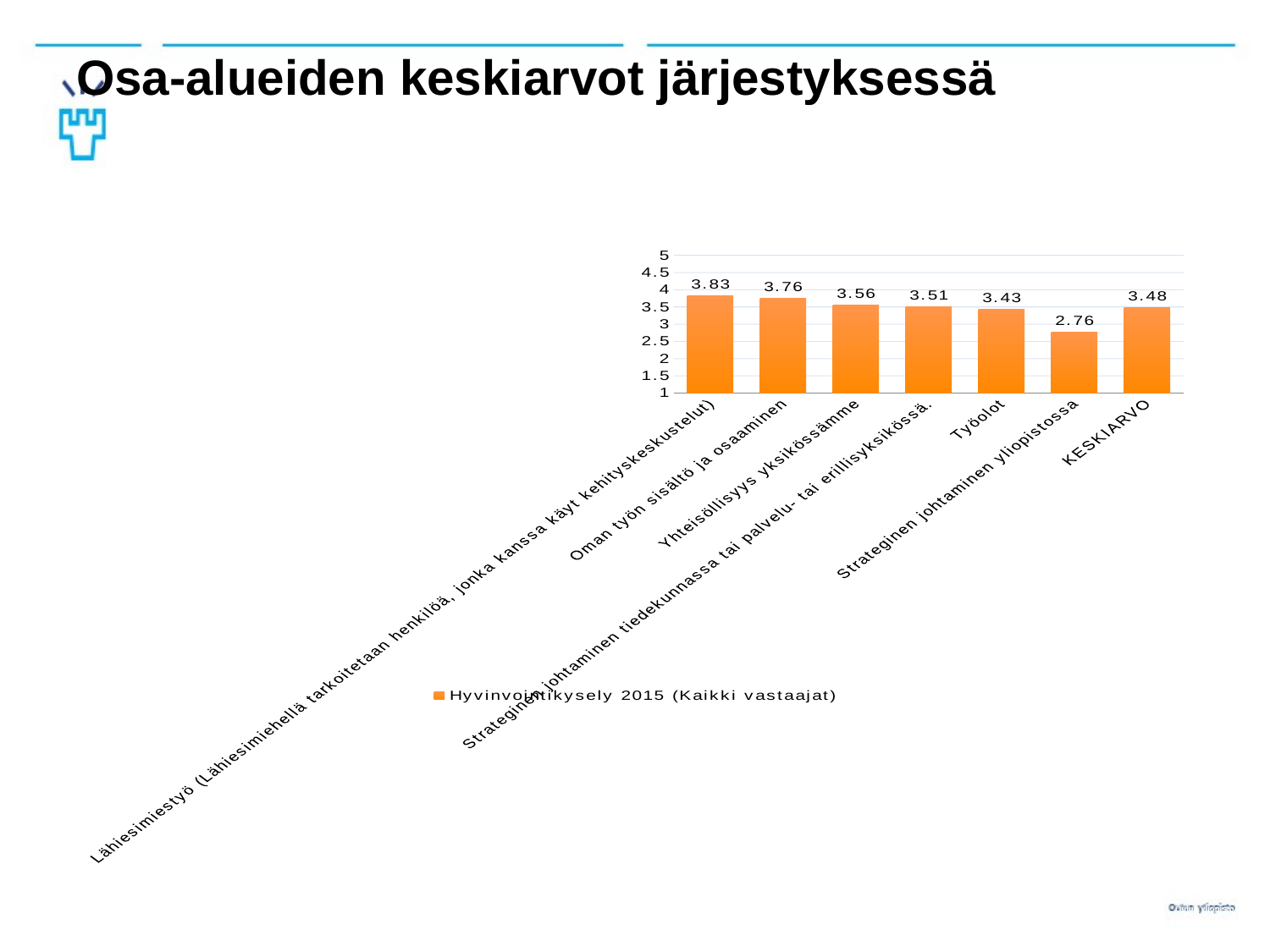
How many series does the legend list? 1 What is the value for Työolot? 3.43 How many categories are shown on the x axis? 7 What is the value for Strateginen johtaminen yliopistossa? 2.76 Which category has the highest value? Lähiesimiestyö (Lähiesimiehellä tarkoitetaan henkilöä, jonka kanssa käyt kehityskeskustelut) Which category has the lowest value? Strateginen johtaminen yliopistossa What is the difference between the values for Yhteisöllisyys yksikössämme and Strateginen johtaminen yliopistossa? 0.80 What is the legend entry of the chart? Hyvinvointikysely 2015 (Kaikki vastaajat) What is the value for KESKIARVO? 3.48 Which is larger, the value for Työolot or the value for KESKIARVO? KESKIARVO What is the value for Oman työn sisältö ja osaaminen? 3.76 What kind of chart is shown on the slide? Bar chart